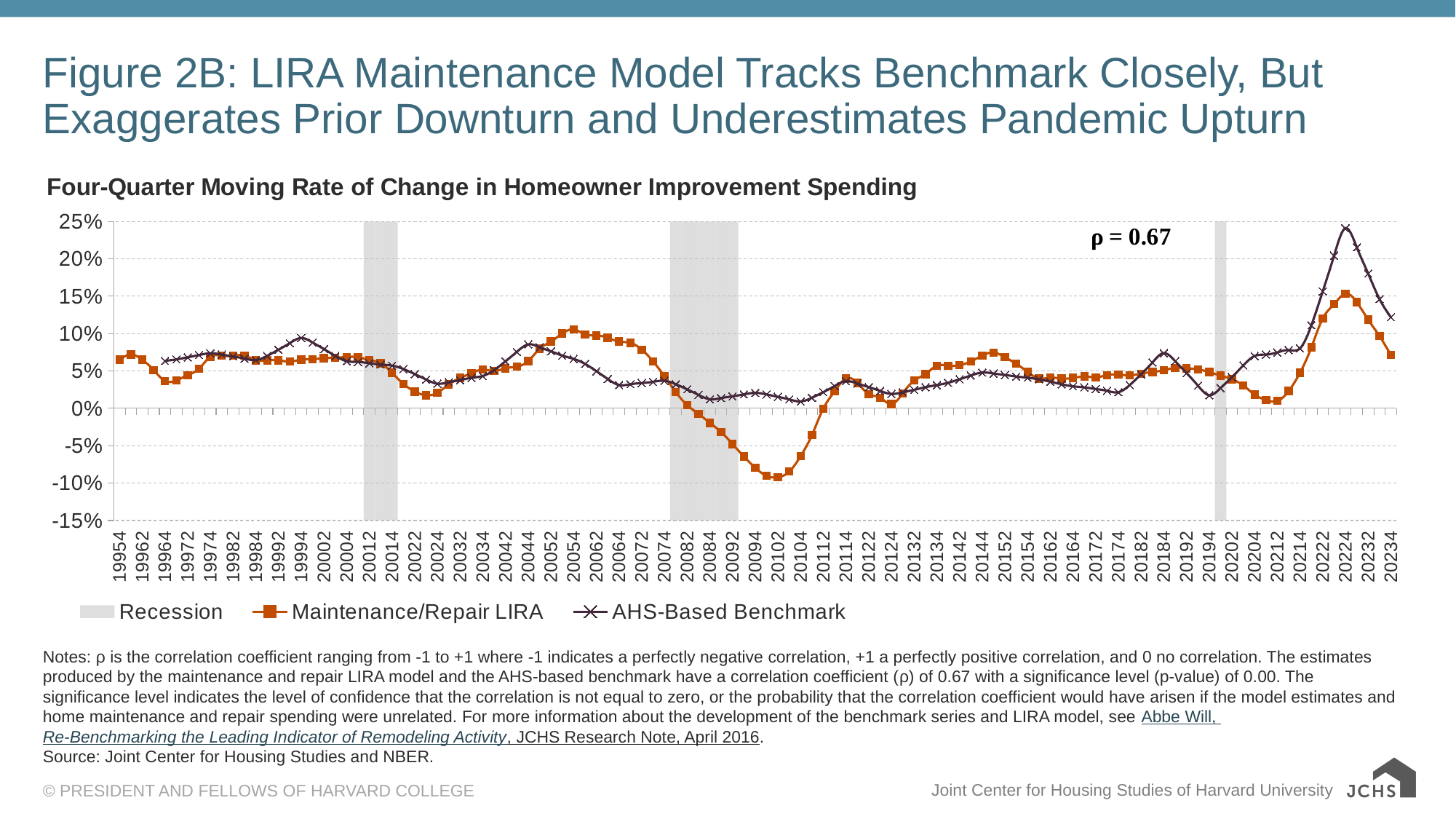
Is the Maintenance/Repair LIRA value at 20224 greater or less than 10%? greater Does the AHS-Based Benchmark series rise or fall between 20212 and 20224? rise At 20102, which series has the higher value, Maintenance/Repair LIRA or AHS-Based Benchmark? AHS-Based Benchmark How many entries does the chart legend list? 3 Which series reaches the highest peak on the chart? AHS-Based Benchmark Is the Maintenance/Repair LIRA value at 20102 greater or less than -5%? less What correlation coefficient (ρ) is printed on the chart? ρ = 0.67 What is the subtitle printed above the chart? Four-Quarter Moving Rate of Change in Homeowner Improvement Spending Is the AHS-Based Benchmark value at 19994 greater or less than 5%? greater What kind of chart is shown on the slide? line chart At 20054, which series has the higher value, Maintenance/Repair LIRA or AHS-Based Benchmark? Maintenance/Repair LIRA